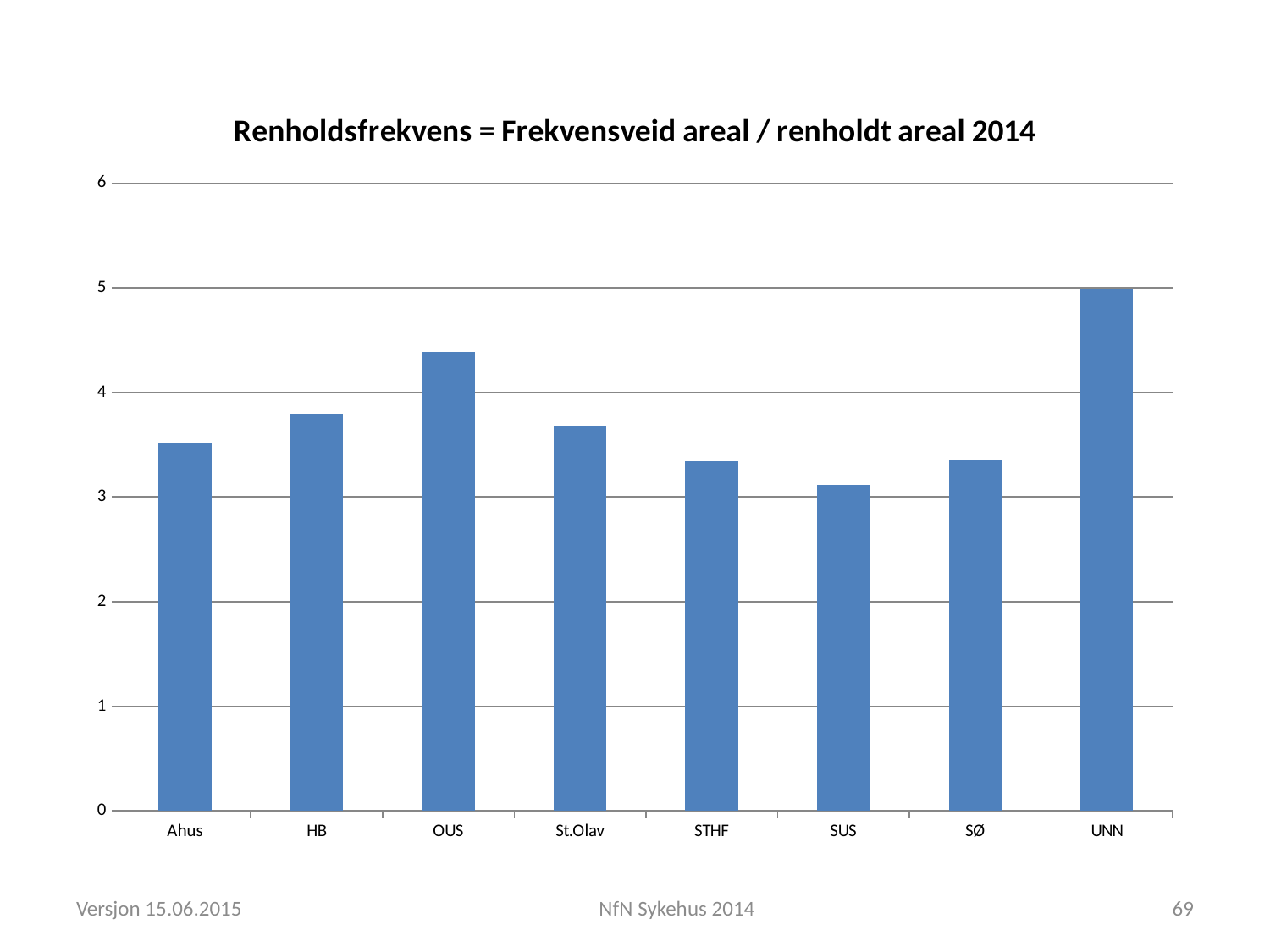
Is the value for OUS greater or less than 4? greater Is the value for SUS greater or less than 3? greater What is the title of the chart? Renholdsfrekvens = Frekvensveid areal / renholdt areal 2014 Which category has the highest value? UNN Which category has the lowest value? SUS Which is larger, the value for Ahus or the value for St.Olav? St.Olav Which is larger, the value for OUS or the value for HB? OUS How many categories are shown on the x axis? 8 What kind of chart is shown on the slide? Bar chart Is the value for HB greater or less than 4? less